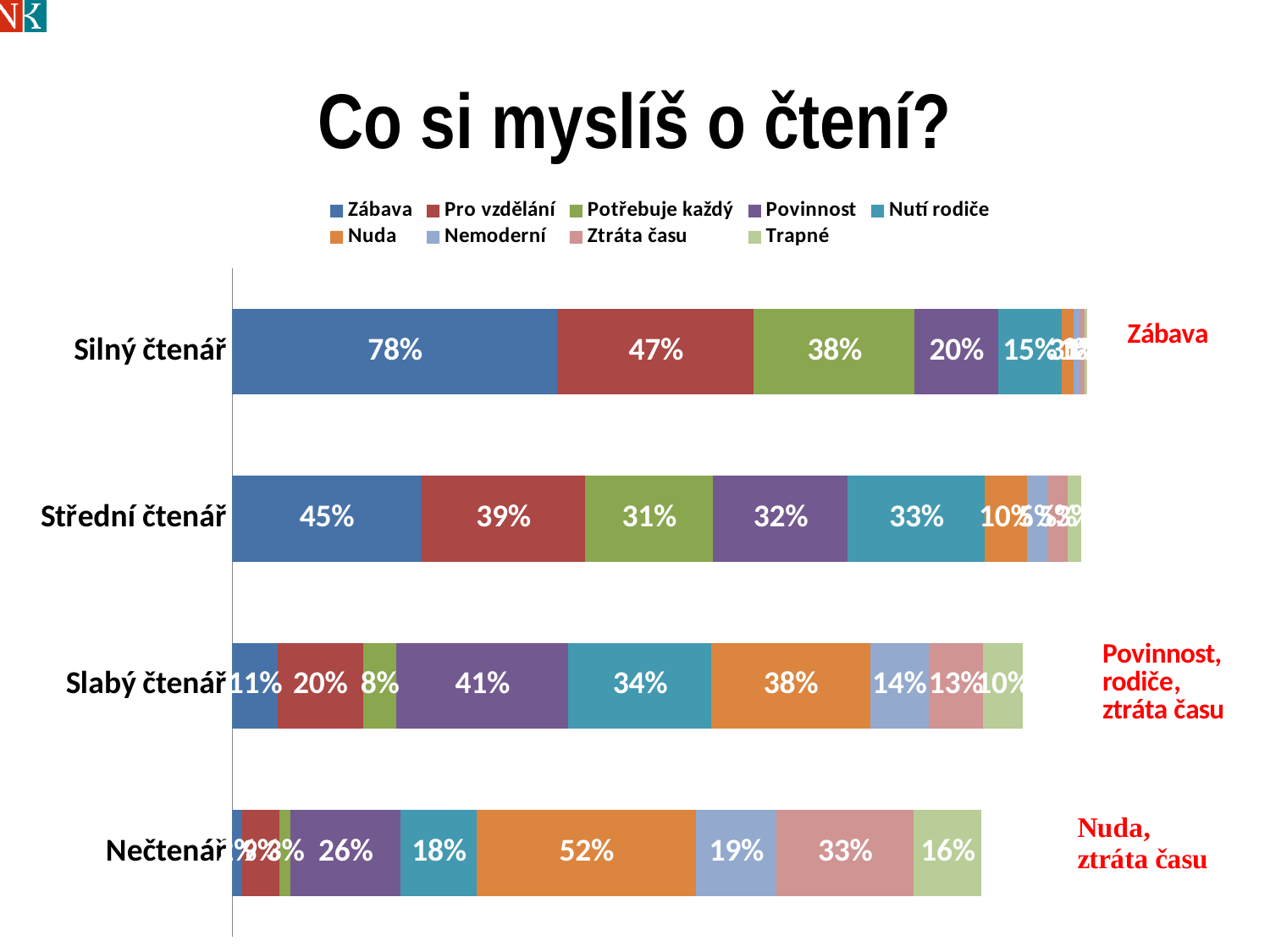
What is the Nuda value for Nečtenář? 52% Which reader category has the highest Zábava value? Silný čtenář What is the title of the chart? Co si myslíš o čtení? What is the Povinnost value for Slabý čtenář? 41% How many reader categories are plotted on the chart? 4 Which reader category has the highest Nuda value? Nečtenář What is the difference between the Zábava values for Silný čtenář and Střední čtenář? 33% What type of chart is shown on the slide? stacked bar chart What is the Nutí rodiče value for Střední čtenář? 33% Which is larger: the Pro vzdělání value for Silný čtenář or for Slabý čtenář? Silný čtenář How many series does the legend list? 9 What is the Zábava value for Silný čtenář? 78%